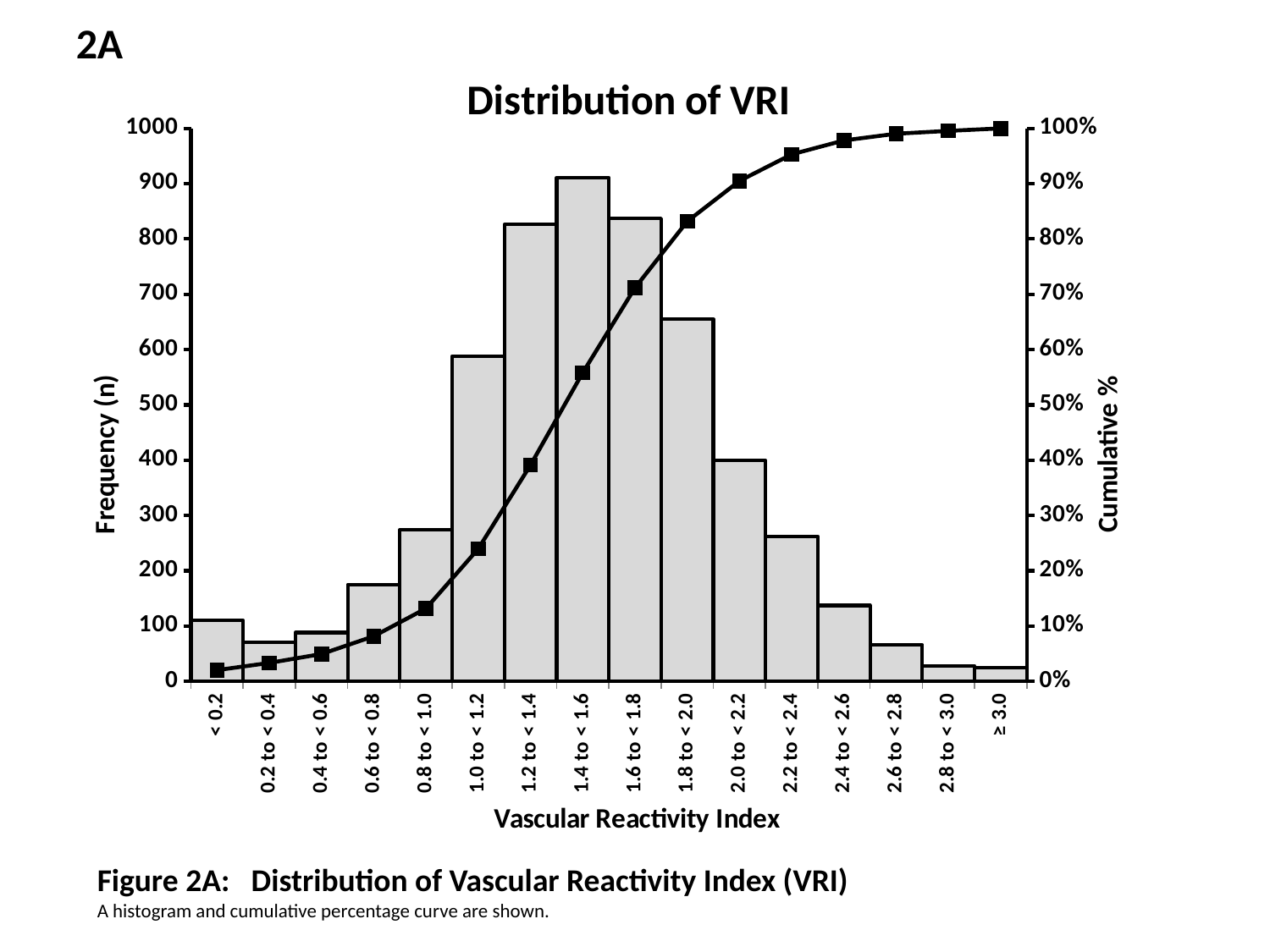
What is the title of the chart? Distribution of VRI What is the label of the left vertical axis? Frequency (n) What type of chart is shown? Bar chart with a cumulative percentage line Is the frequency for the 0.8 to < 1.0 category greater or less than 300? less Which has a higher frequency, the 0.6 to < 0.8 category or the 2.4 to < 2.6 category? 0.6 to < 0.8 Is the frequency for the 1.4 to < 1.6 category greater or less than 800? greater Which has a higher frequency, the 1.8 to < 2.0 category or the 1.0 to < 1.2 category? 1.8 to < 2.0 How many VRI categories are shown on the x axis? 16 Is the frequency for the 1.0 to < 1.2 category greater or less than 500? greater Does the cumulative percentage line rise or fall as VRI increases along the x axis? rise Which VRI category has the highest frequency? 1.4 to < 1.6